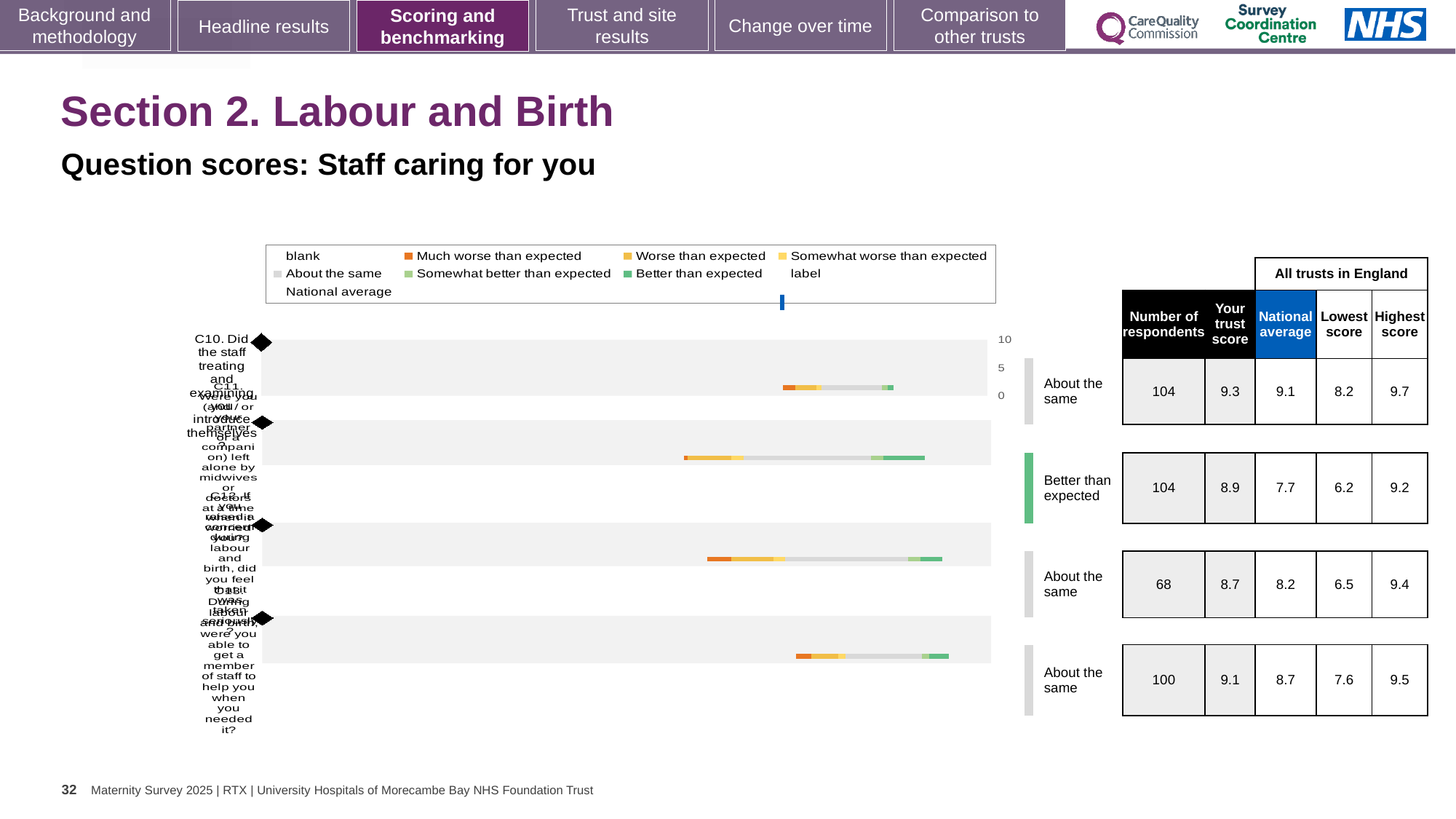
For the second row (C11), what is the difference between the trust score and the national average? 1.2 How many question rows (bars) does the chart show? 4 In the table beside the chart, what is the lowest score for the first row (C10)? 8.2 In the table beside the chart, what is the national average for the third row (C12)? 8.2 In the table beside the chart, what is the trust score for the second row (C11)? 8.9 In the table beside the chart, what is the number of respondents for the first row (C10)? 104 Which row has the highest trust score in the table beside the chart? the first row (C10), 9.3 In the table beside the chart, what is the highest score for the fourth row (C13)? 9.5 For the fourth row (C13), which is larger: the trust score or the national average? the trust score (9.1) Which row is rated 'Better than expected' in the labels beside the chart? the second row (C11) What kind of chart is shown on the slide? bar chart Which row has the lowest number of respondents in the table beside the chart? the third row (C12), 68